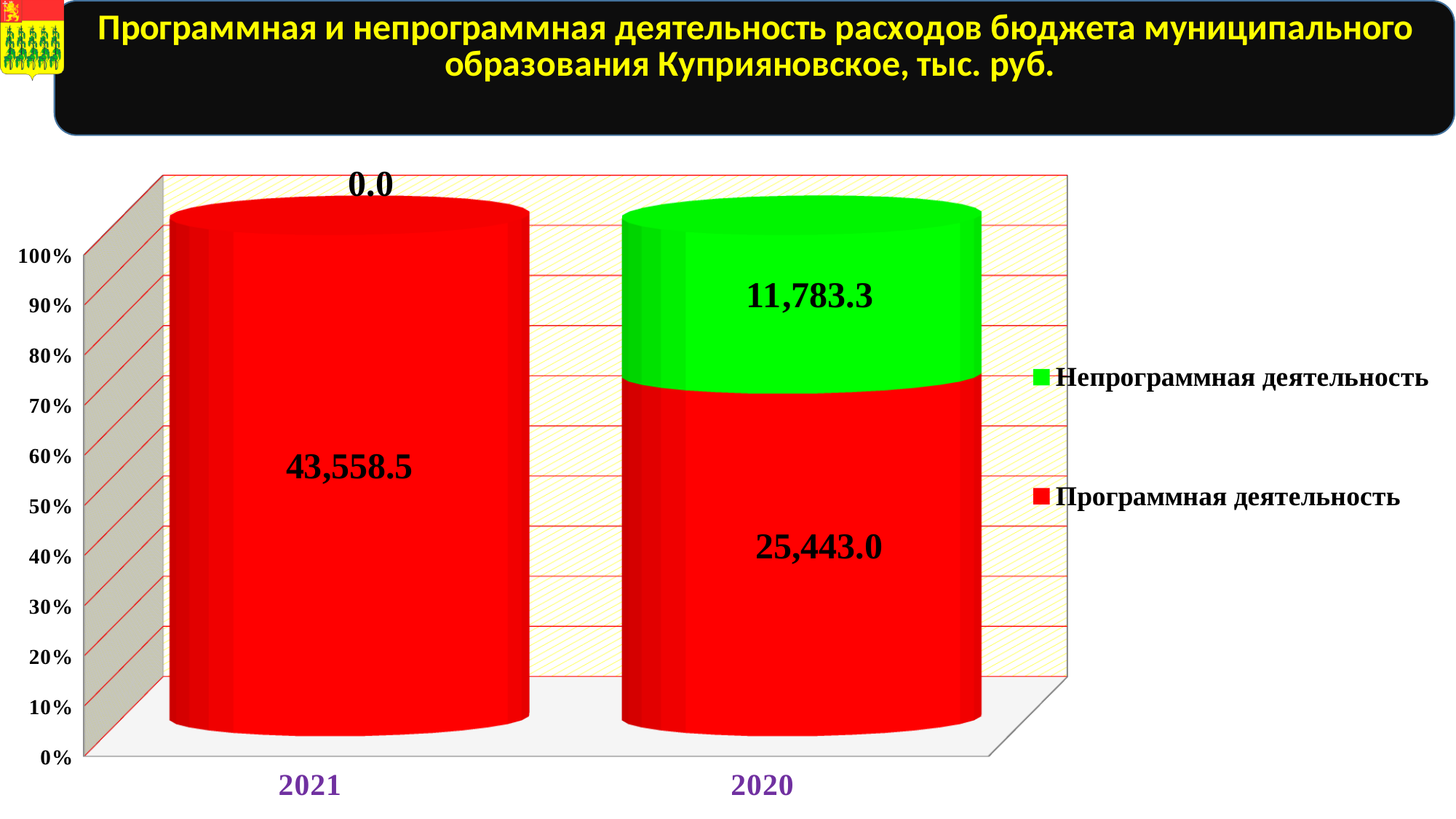
What is the value for Непрограммная деятельность in 2021? 0.0 Which colour represents Непрограммная деятельность in the legend? Green In 2020, what is the difference between Программная деятельность and Непрограммная деятельность? 13,659.7 What is the difference between the Программная деятельность values for 2021 and 2020? 18,115.5 How many series does the legend list? 2 What is the total of the stacked bar for 2020? 37,226.3 What is the value for Непрограммная деятельность in 2020? 11,783.3 What is the value for Программная деятельность in 2020? 25,443.0 What kind of chart is shown on the slide? Stacked bar chart What is the value for Программная деятельность in 2021? 43,558.5 How many years are shown on the x axis? 2 Which year has the higher value for Программная деятельность? 2021